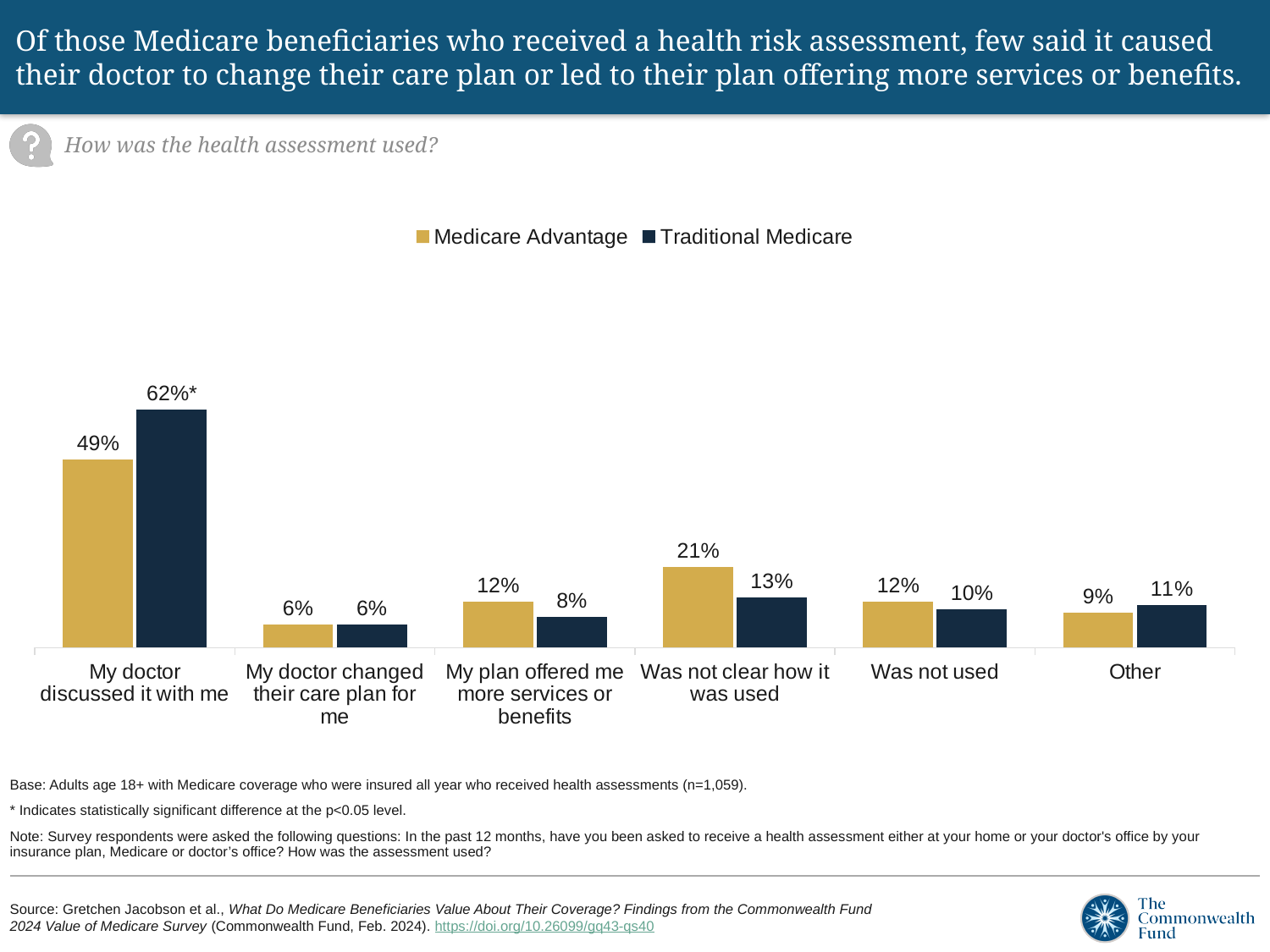
How many series does the legend list? 2 What percentage of Traditional Medicare beneficiaries said it was not clear how the assessment was used? 13% Which category has the lowest value for Traditional Medicare? My doctor changed their care plan for me What percentage of Traditional Medicare beneficiaries said their doctor discussed the health assessment with them? 62%* Which series is shown in dark blue in the legend? Traditional Medicare What percentage of Medicare Advantage beneficiaries said their doctor discussed the health assessment with them? 49% What is the difference between the Medicare Advantage and Traditional Medicare values for 'My plan offered me more services or benefits'? 4 percentage points How many categories are shown on the x axis? 6 Which category has the highest value for Medicare Advantage? My doctor discussed it with me For 'Was not clear how it was used', which series has the larger value, Medicare Advantage or Traditional Medicare? Medicare Advantage What kind of chart is shown on the slide? Bar chart What is the difference between the Traditional Medicare and Medicare Advantage values for 'My doctor discussed it with me'? 13 percentage points